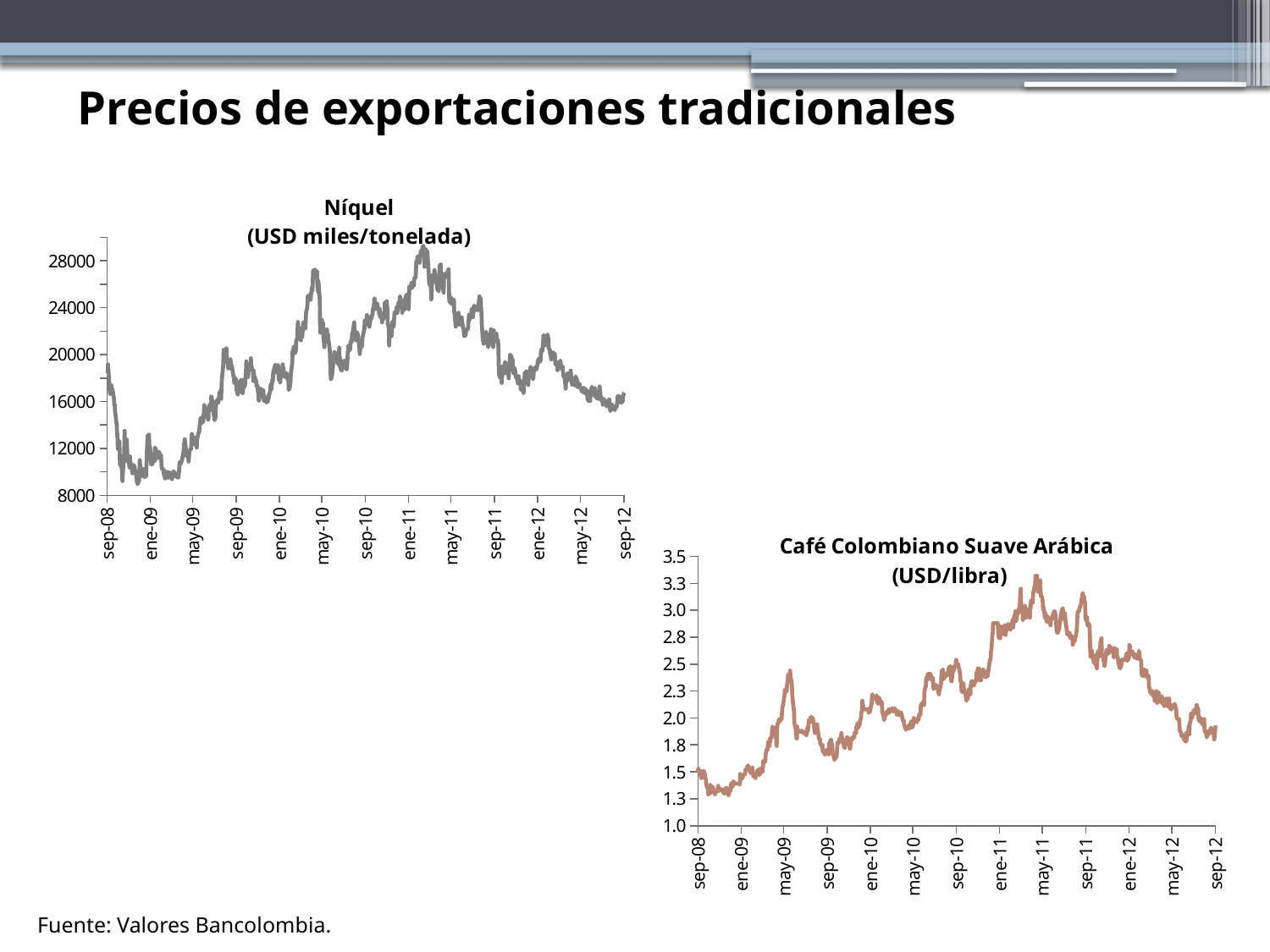
In the Café Colombiano Suave Arábica chart, is the peak value reached around may-11 greater or less than 3.0? greater What kind of chart is the Níquel chart? line chart What unit is shown in the title of the Café Colombiano Suave Arábica chart? USD/libra In the Níquel chart, is the peak value reached around ene-11 greater or less than 28000? greater In the Café Colombiano Suave Arábica chart, is the value at sep-12 greater or less than 2.3? less In the Café Colombiano Suave Arábica chart, do values rise or fall between sep-08 and may-11? rise In the Níquel chart, do values rise or fall between ene-11 and sep-12? fall In the Níquel chart, is the value higher at sep-08 or at sep-12? sep-08 What kind of chart is the Café Colombiano Suave Arábica chart? line chart